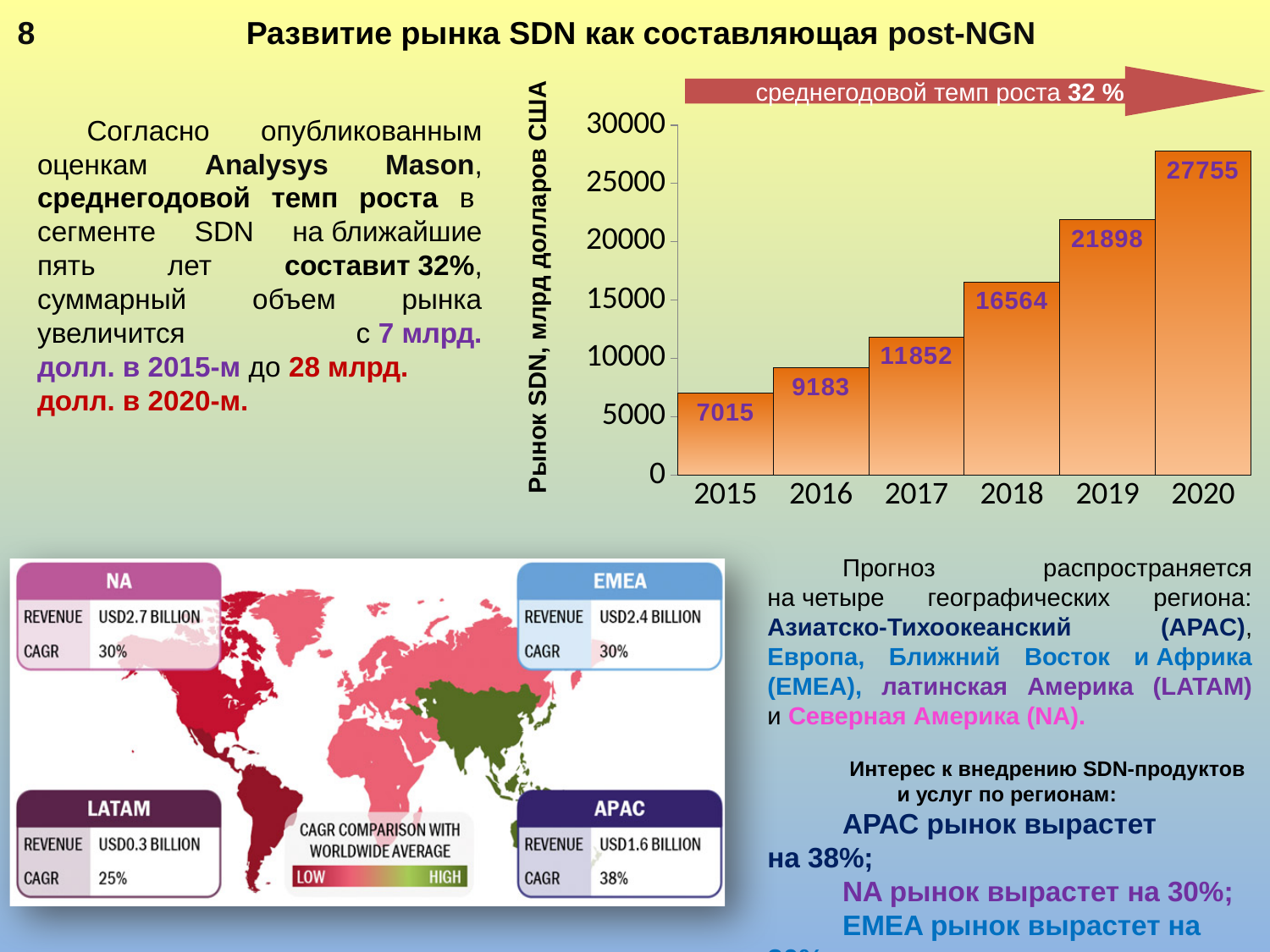
Which is larger in the bar chart, the value for 2019 or the value for 2018? 2019 What kind of chart is used to show the SDN market by year? bar chart What is the value for 2018 in the bar chart? 16564 What is the value for 2015 in the bar chart? 7015 What is the value for 2020 in the bar chart? 27755 Is the value for 2019 in the bar chart greater or less than 20000? greater Do the values in the bar chart rise or fall from 2015 to 2020? rise How many years are shown on the x axis of the bar chart? 6 What is the difference between the values for 2020 and 2015 in the bar chart? 20740 Which year has the highest value in the bar chart? 2020 What is the difference between the values for 2017 and 2016 in the bar chart? 2669 Which year has the lowest value in the bar chart? 2015